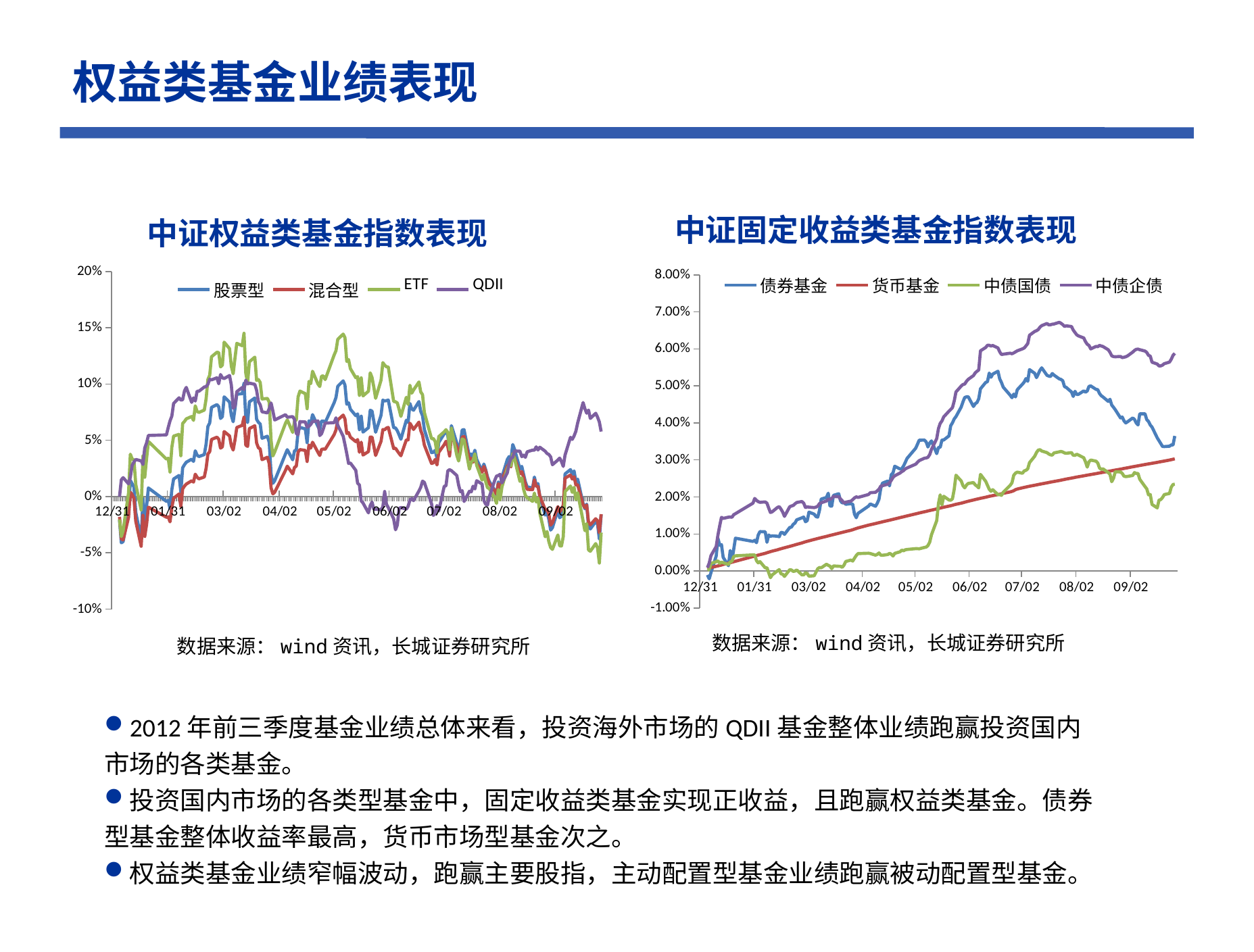
In the 中证固定收益类基金指数表现 chart on the right, is the final value of 中债国债 greater or less than 3.00%? less What kind of chart is the 中证权益类基金指数表现 chart on the left? line chart In the 中证权益类基金指数表现 chart on the left, is the peak value of ETF greater or less than 10%? greater In the 中证固定收益类基金指数表现 chart on the right, does the 货币基金 series rise or fall over the period shown? rise In the 中证权益类基金指数表现 chart on the left, which series reaches the highest peak? ETF In the 中证固定收益类基金指数表现 chart on the right, at the end of the period, which is higher: 中债企债 or 中债国债? 中债企债 In the 中证固定收益类基金指数表现 chart on the right, which series is drawn in red? 货币基金 In the 中证固定收益类基金指数表现 chart on the right, is the peak value of 中债企债 greater or less than 6.00%? greater Which series are listed in the legend of the 中证权益类基金指数表现 chart on the left? 股票型, 混合型, ETF, QDII In the 中证权益类基金指数表现 chart on the left, at the end of the period, which is higher: QDII or ETF? QDII How many series does the legend of the 中证固定收益类基金指数表现 chart on the right list? 4 In the 中证固定收益类基金指数表现 chart on the right, which series reaches the highest peak? 中债企债